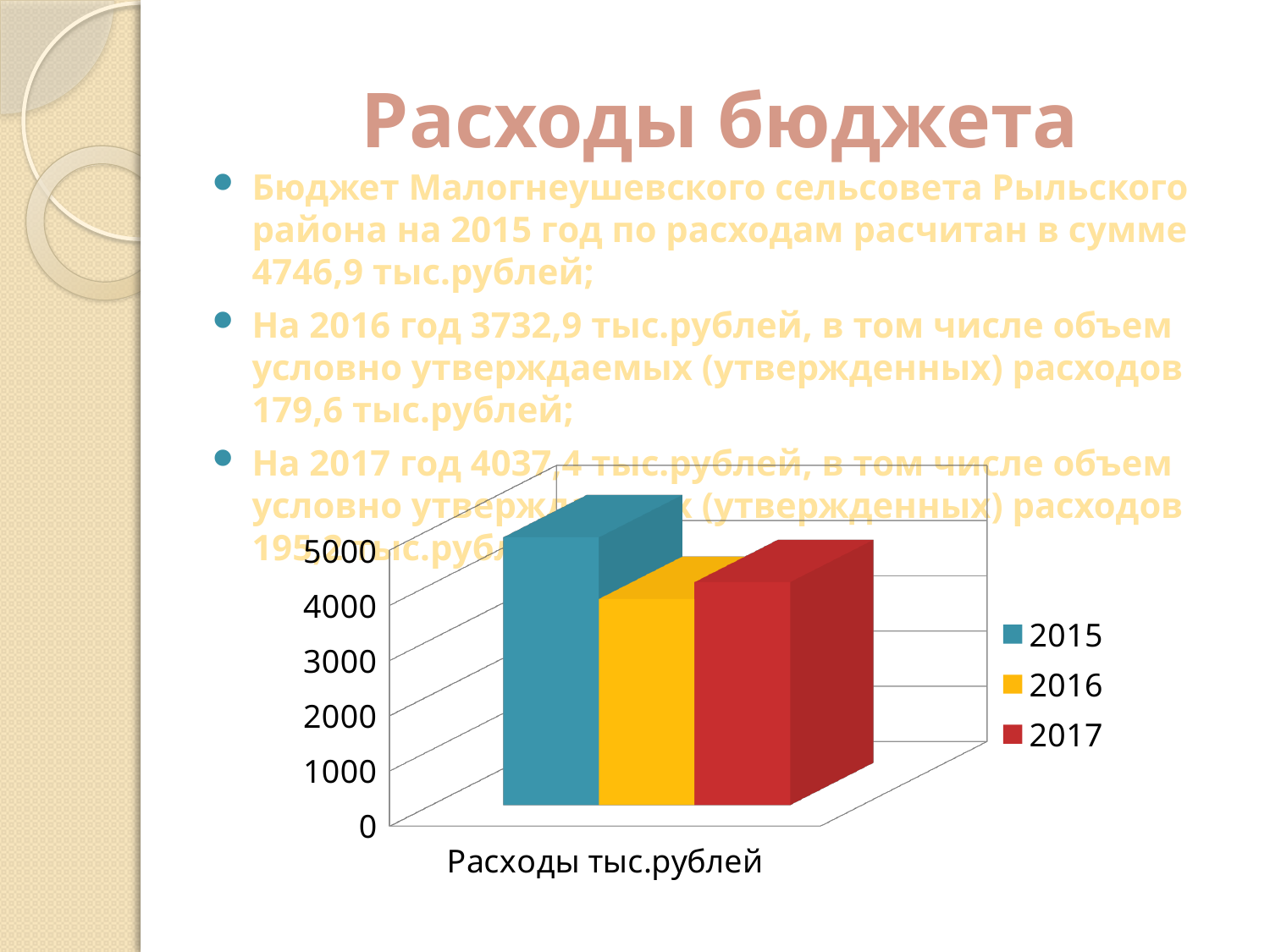
What kind of chart is shown on the slide? bar chart What is the category label shown on the x axis of the chart? Расходы тыс.рублей Which is larger in the chart, the bar for 2015 or the bar for 2017? 2015 Is the bar for 2016 greater or less than 4000? less Is the bar for 2015 greater or less than 4000? greater Is the bar for 2015 greater or less than 5000? less How many series does the chart legend list? 3 Which is larger in the chart, the bar for 2016 or the bar for 2017? 2017 What colour is the bar for 2016 in the chart? yellow Which year has the highest bar in the chart? 2015 Which year has the lowest bar in the chart? 2016